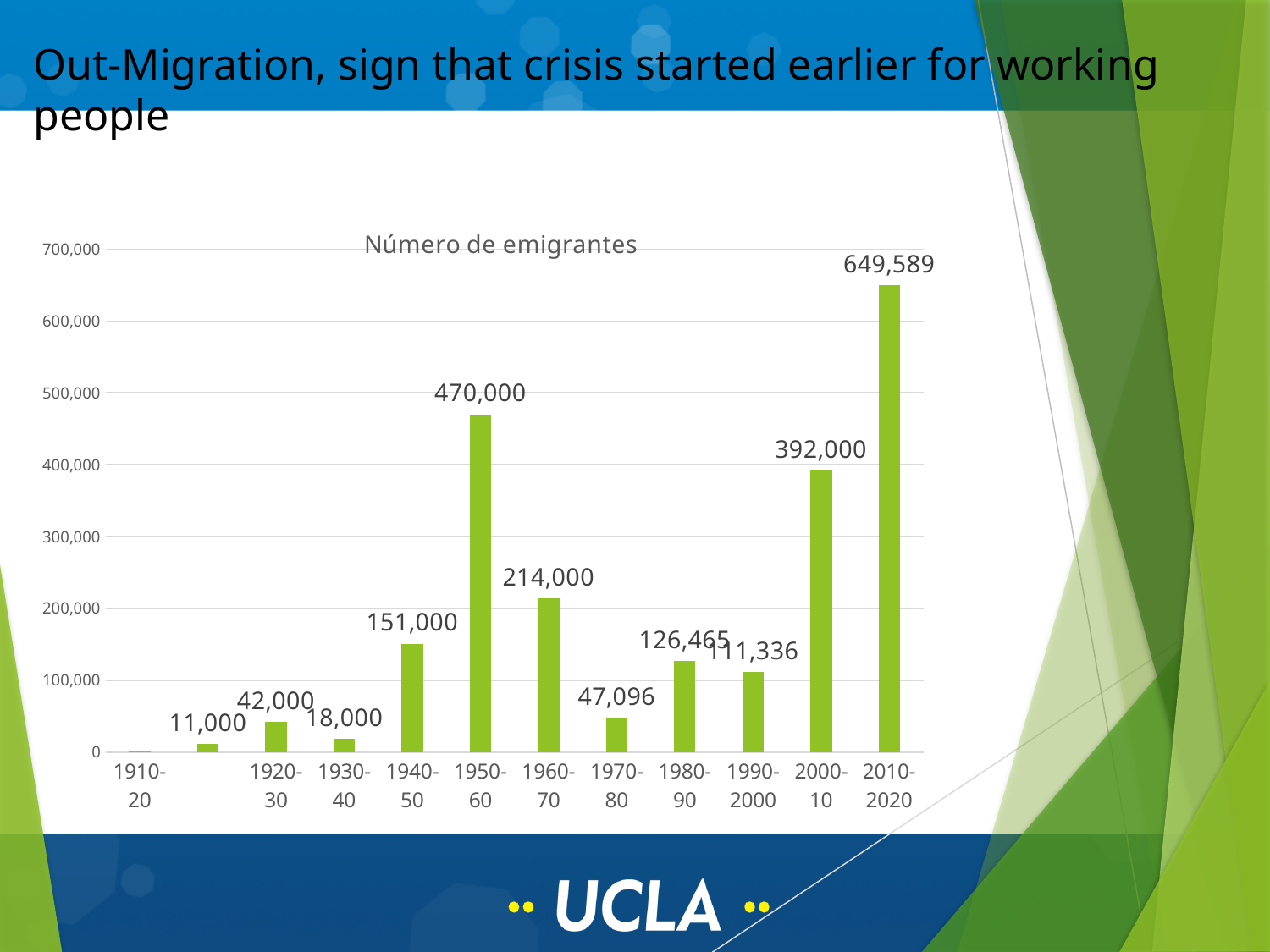
What is the number of emigrants for 1990-2000? 111,336 What type of chart is shown on the slide? bar chart Which period has more emigrants, 1960-70 or 1980-90? 1960-70 Which period has the highest number of emigrants? 2010-2020 Is the value for 1970-80 greater or less than 100,000? less What is the number of emigrants for 1950-60? 470,000 How many bars are plotted in the chart? 12 What is the number of emigrants for 2010-2020? 649,589 Which period has the lowest number of emigrants? 1910-20 What is the title of the chart? Número de emigrantes What is the difference between the number of emigrants in 2010-2020 and in 2000-10? 257,589 What is the number of emigrants for 1970-80? 47,096